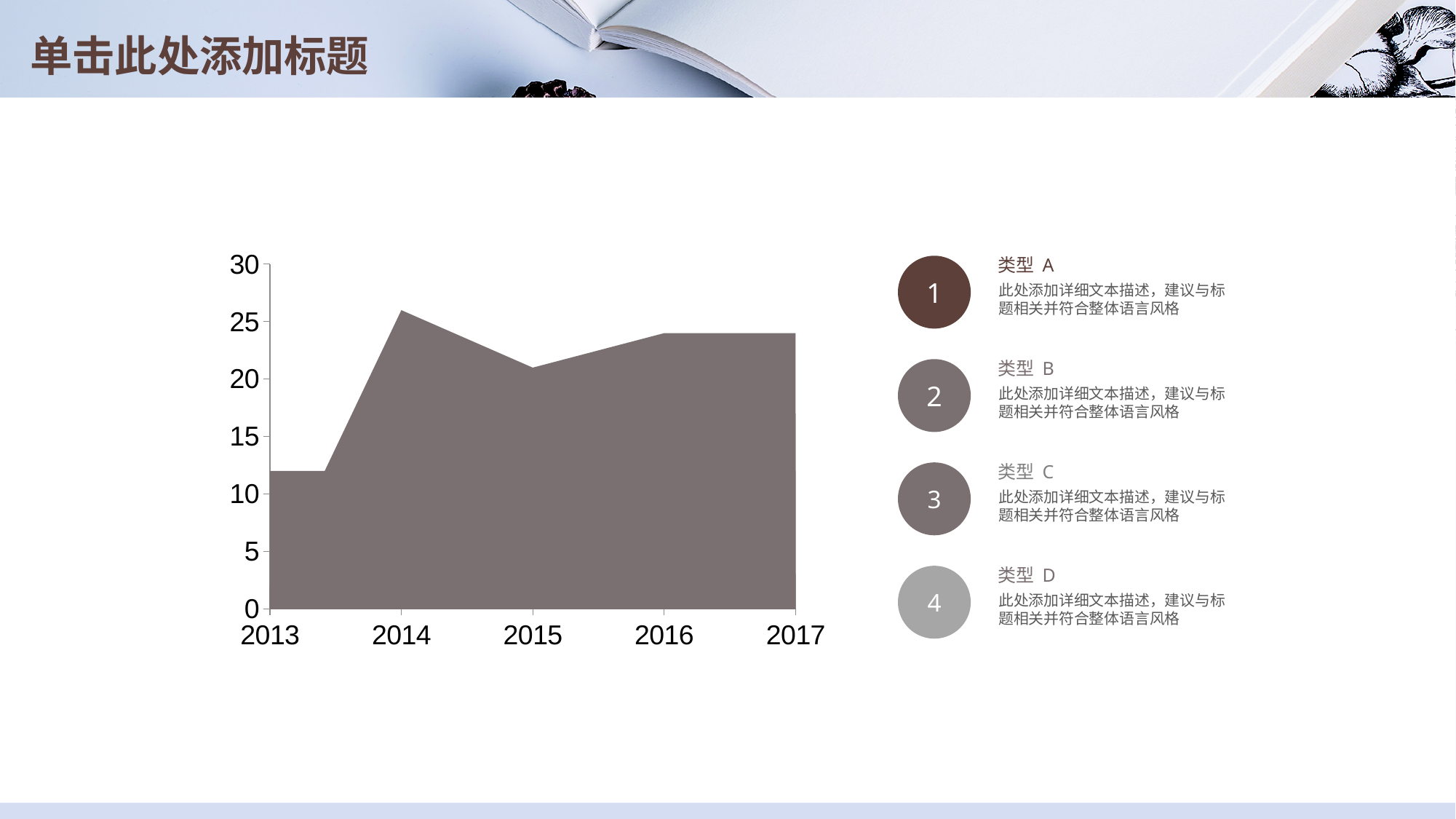
Which is larger, the value for 2013 or the value for 2014? 2014 Which is larger, the value for 2014 or the value for 2015? 2014 Does the value rise or fall from 2014 to 2015? fall Is the value for 2014 greater or less than 25? greater Is the value for 2015 greater or less than 20? greater Which year has the highest value in the chart? 2014 Is the value for 2016 greater or less than 25? less What kind of chart is shown on the slide? area chart How many years are shown on the x axis of the chart? 5 Which year has the lowest value in the chart? 2013 What is the first year shown on the x axis of the chart? 2013